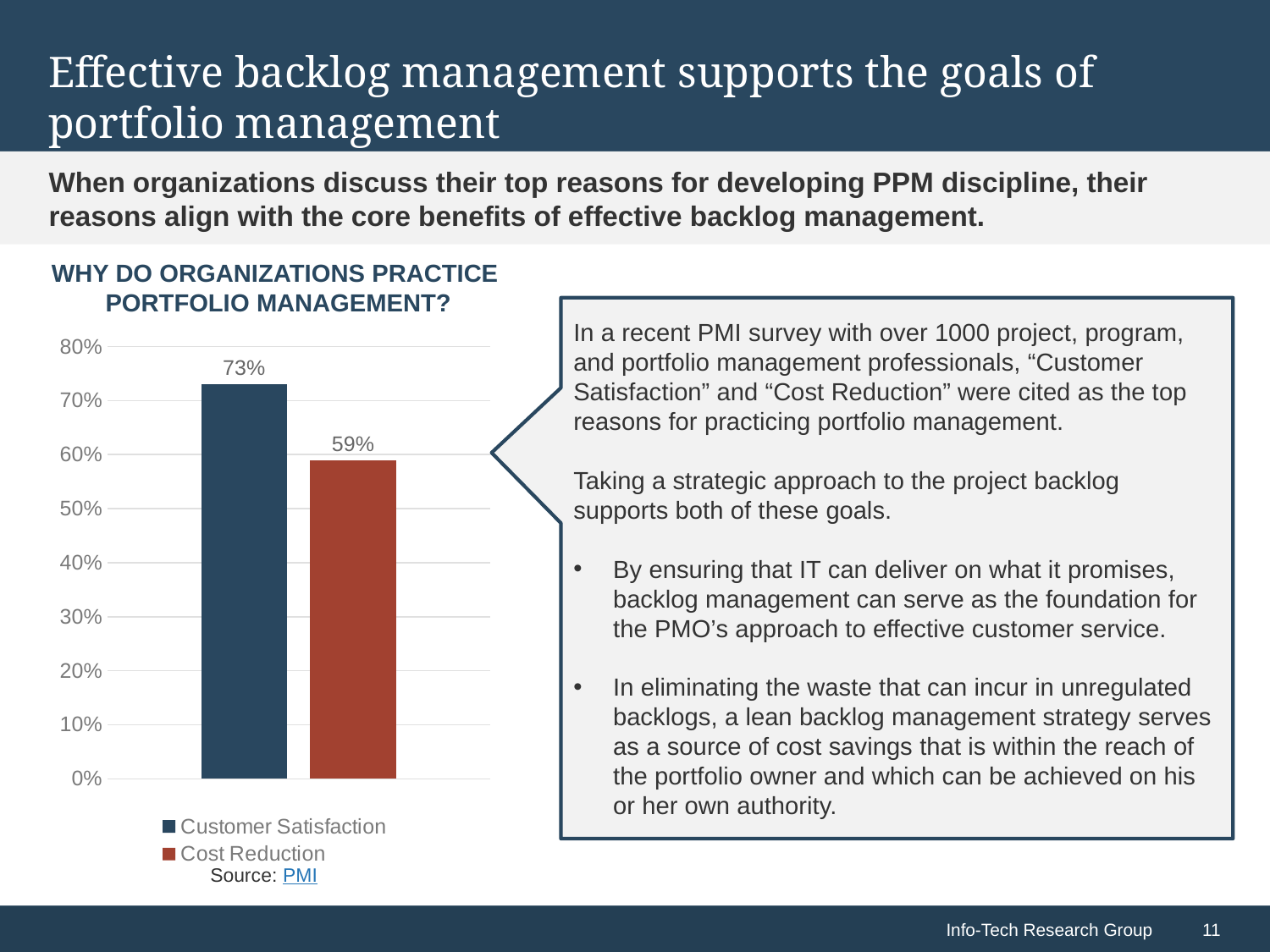
Which category has the lowest value? Cost Reduction Which is larger, the value for Customer Satisfaction or the value for Cost Reduction? Customer Satisfaction How many entries does the legend list? 2 What kind of chart is shown on the slide? Bar chart What is the title of the chart? WHY DO ORGANIZATIONS PRACTICE PORTFOLIO MANAGEMENT? Is the value for Cost Reduction greater or less than 60%? less What is the value for Cost Reduction? 59% What is the value for Customer Satisfaction? 73% How many bars are plotted in the chart? 2 What is the difference between the values for Customer Satisfaction and Cost Reduction? 14% Which category has the highest value? Customer Satisfaction Is the value for Customer Satisfaction greater or less than 70%? greater